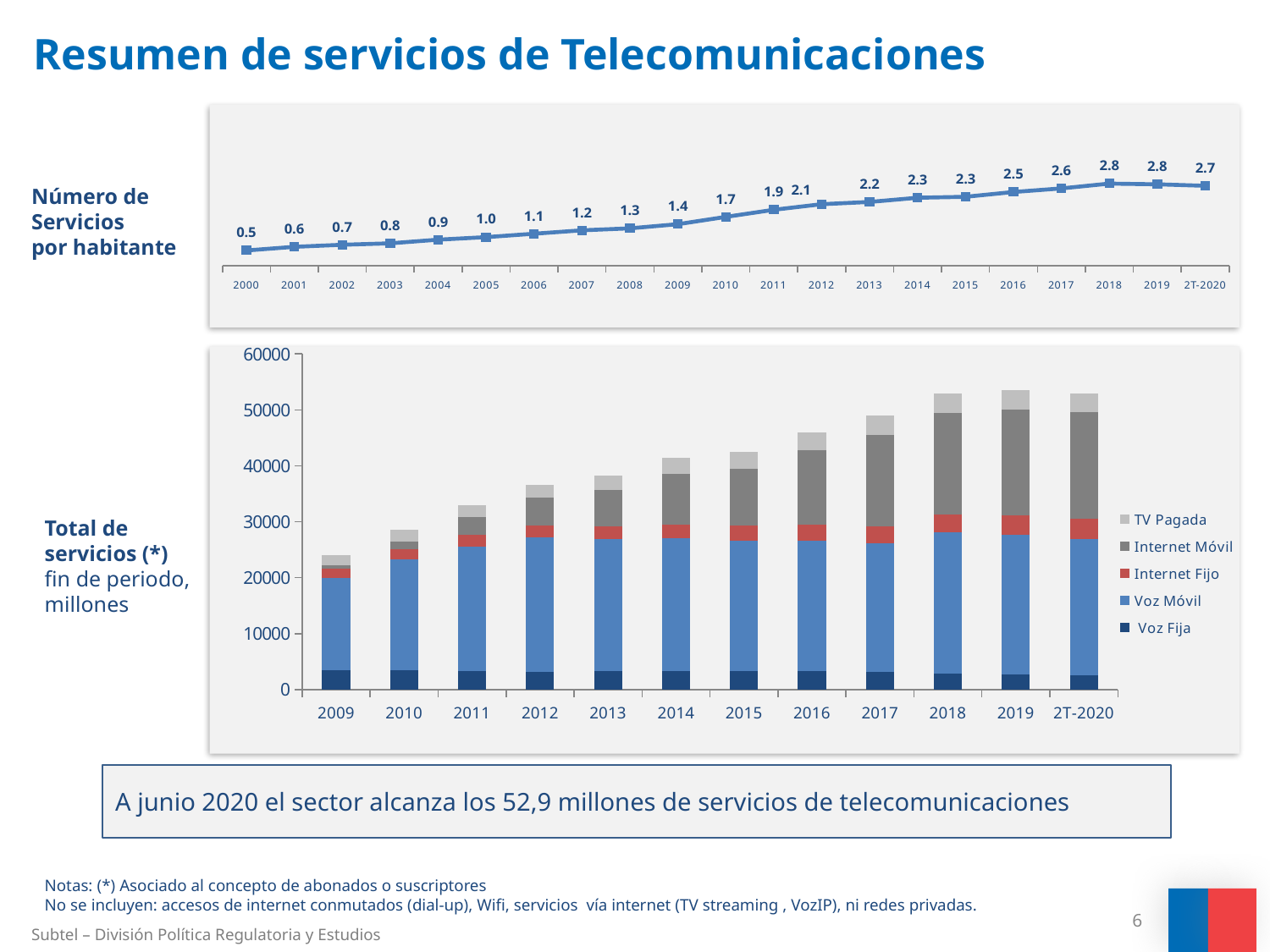
In the top chart (Número de Servicios por habitante), how many data points are plotted? 21 In the top chart (Número de Servicios por habitante), what is the difference between the values for 2019 and 2009? 1.4 In the top chart (Número de Servicios por habitante), what is the value for 2T-2020? 2.7 In the bottom chart (Total de servicios), is the total for 2009 greater or less than 30000? less In the top chart (Número de Servicios por habitante), which year has the lowest value? 2000 In the top chart (Número de Servicios por habitante), which is larger, the value for 2012 or the value for 2016? 2016 In the bottom chart (Total de servicios), how many series does the legend list? 5 In the bottom chart (Total de servicios), is the total for 2019 greater or less than 50000? greater What kind of chart is the top chart (Número de Servicios por habitante)? line chart What kind of chart is the bottom chart (Total de servicios)? stacked bar chart In the top chart (Número de Servicios por habitante), what is the value for 2010? 1.7 In the top chart (Número de Servicios por habitante), do the values generally rise or fall from 2000 to 2018? rise